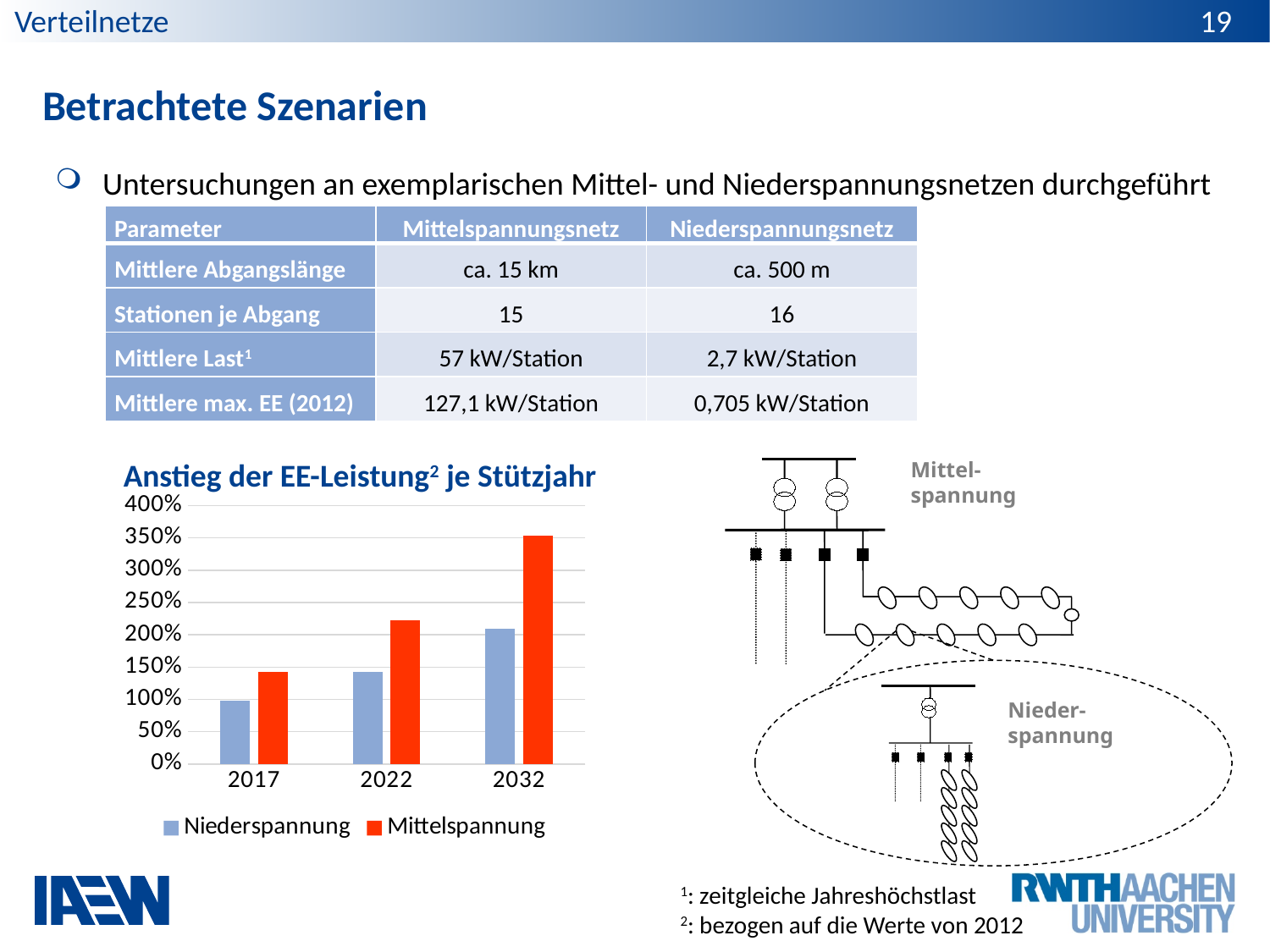
What colour are the Mittelspannung bars in the chart? red How many series does the chart legend list? 2 Which bar in the chart is the highest? Mittelspannung in 2032 Is the value for Mittelspannung in 2022 greater or less than 200%? greater What is the title of the chart? Anstieg der EE-Leistung² je Stützjahr How many years are shown on the x axis of the chart? 3 What kind of chart is shown on the slide? bar chart Is the value for Mittelspannung in 2032 greater or less than 300%? greater Do the Mittelspannung values rise or fall from 2017 to 2032? rise In 2032, which is larger: Niederspannung or Mittelspannung? Mittelspannung Which bar in the chart is the lowest? Niederspannung in 2017 Is the value for Niederspannung in 2022 greater or less than 150%? less